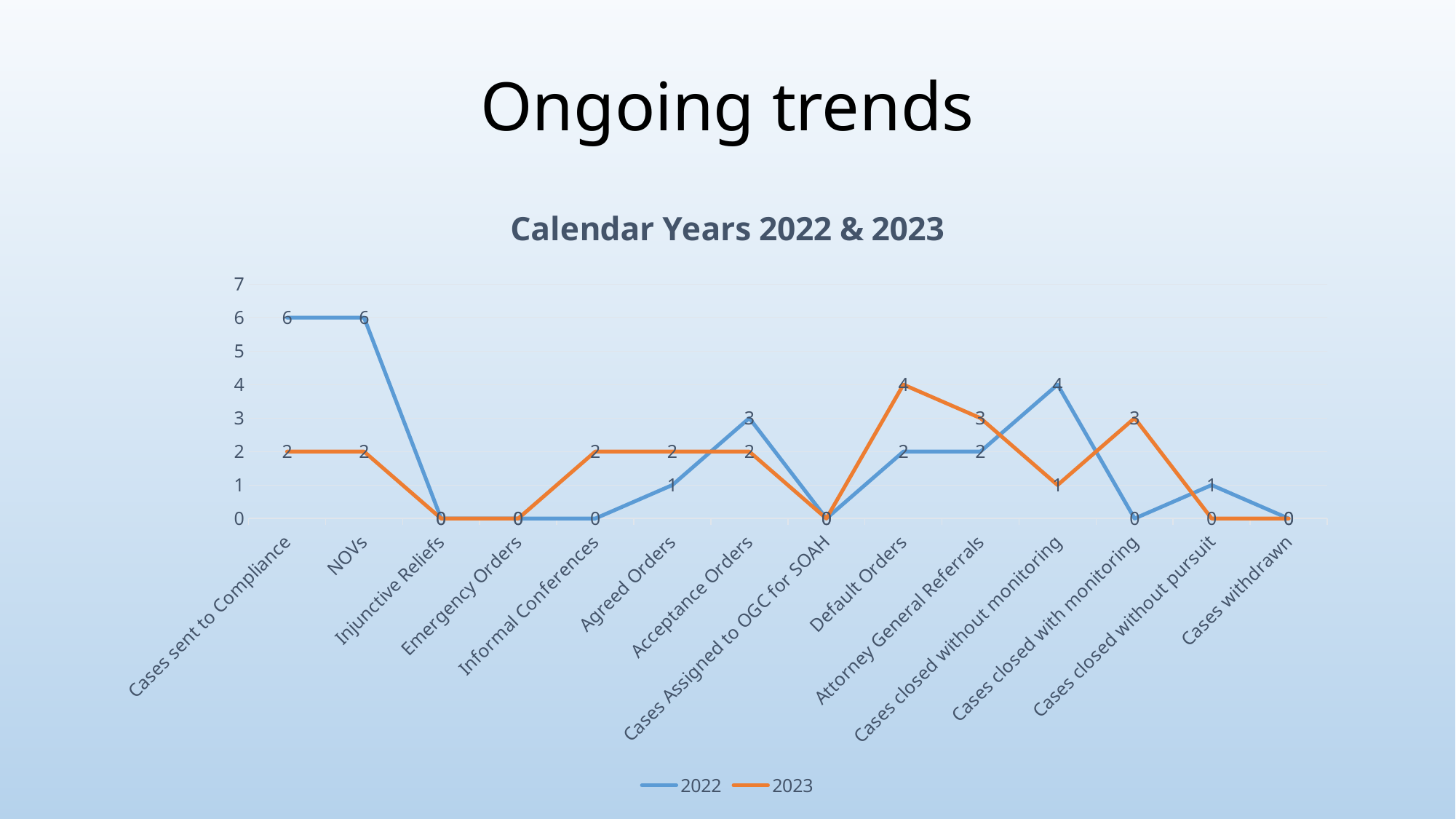
How many series does the legend list? 2 What is the 2023 value for Cases closed with monitoring? 3 What is the 2023 value for Default Orders? 4 How many categories are plotted along the x axis? 14 What kind of chart is shown on the slide? line chart Which category has the highest 2023 value? Default Orders What is the difference between the 2022 and 2023 values for NOVs? 4 What is the 2022 value for Cases sent to Compliance? 6 What is the difference between the 2022 value for Acceptance Orders and the 2022 value for Agreed Orders? 2 What is the title of the chart? Calendar Years 2022 & 2023 Which is larger for Attorney General Referrals, the 2022 value or the 2023 value? 2023 What is the 2022 value for Cases closed without monitoring? 4